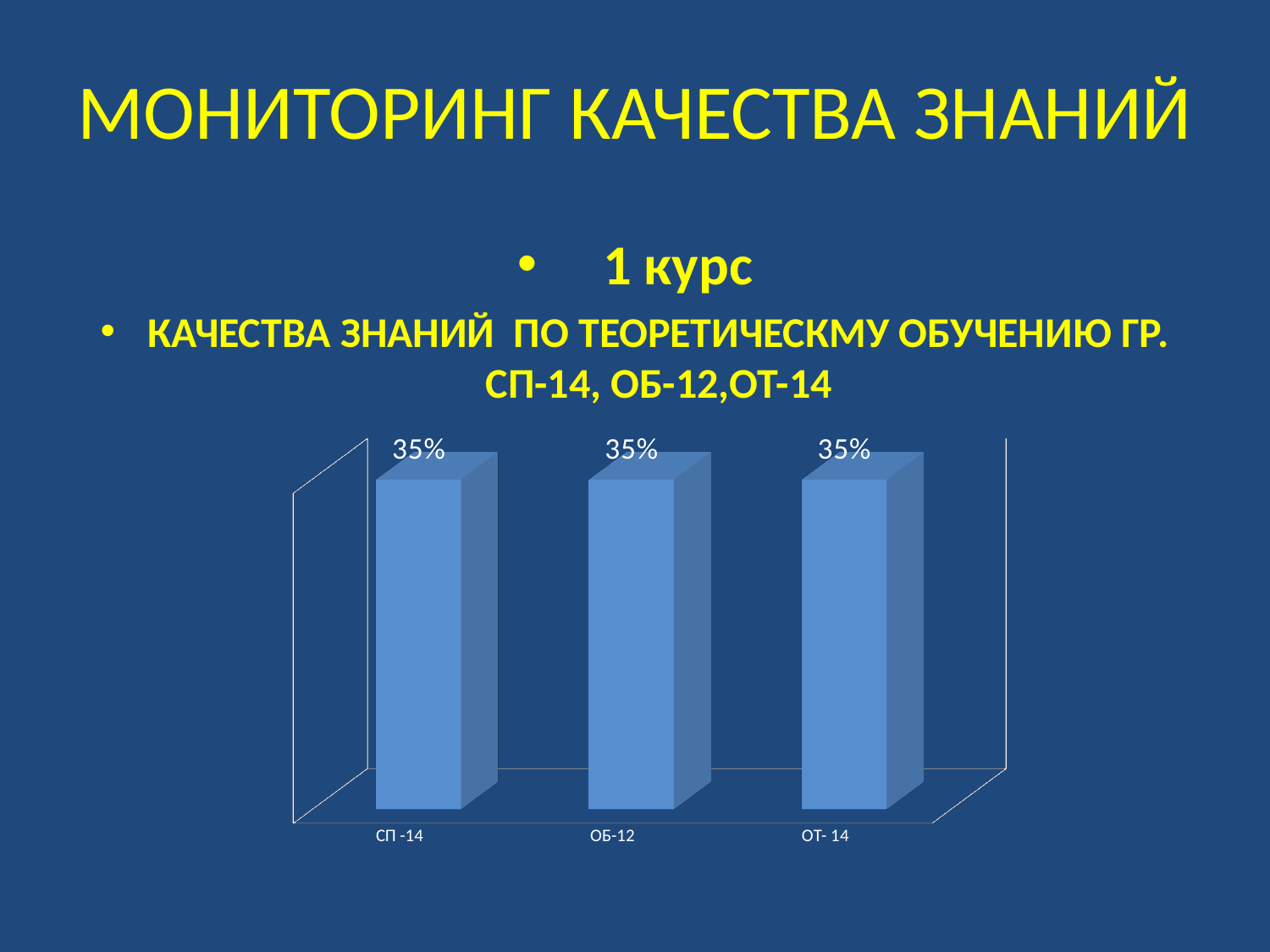
What is the difference between the values for ОБ-12 and ОТ- 14? 0% What is the value for СП -14? 35% What is the value for ОБ-12? 35% What is the value for ОТ- 14? 35% What is the difference between the values for СП -14 and ОБ-12? 0% What kind of chart is shown on the slide? bar chart What colour are the bars in the chart? blue How many categories are shown on the chart? 3 What is the label of the leftmost bar? СП -14 Do the values rise, fall, or stay the same across the categories from left to right? stay the same